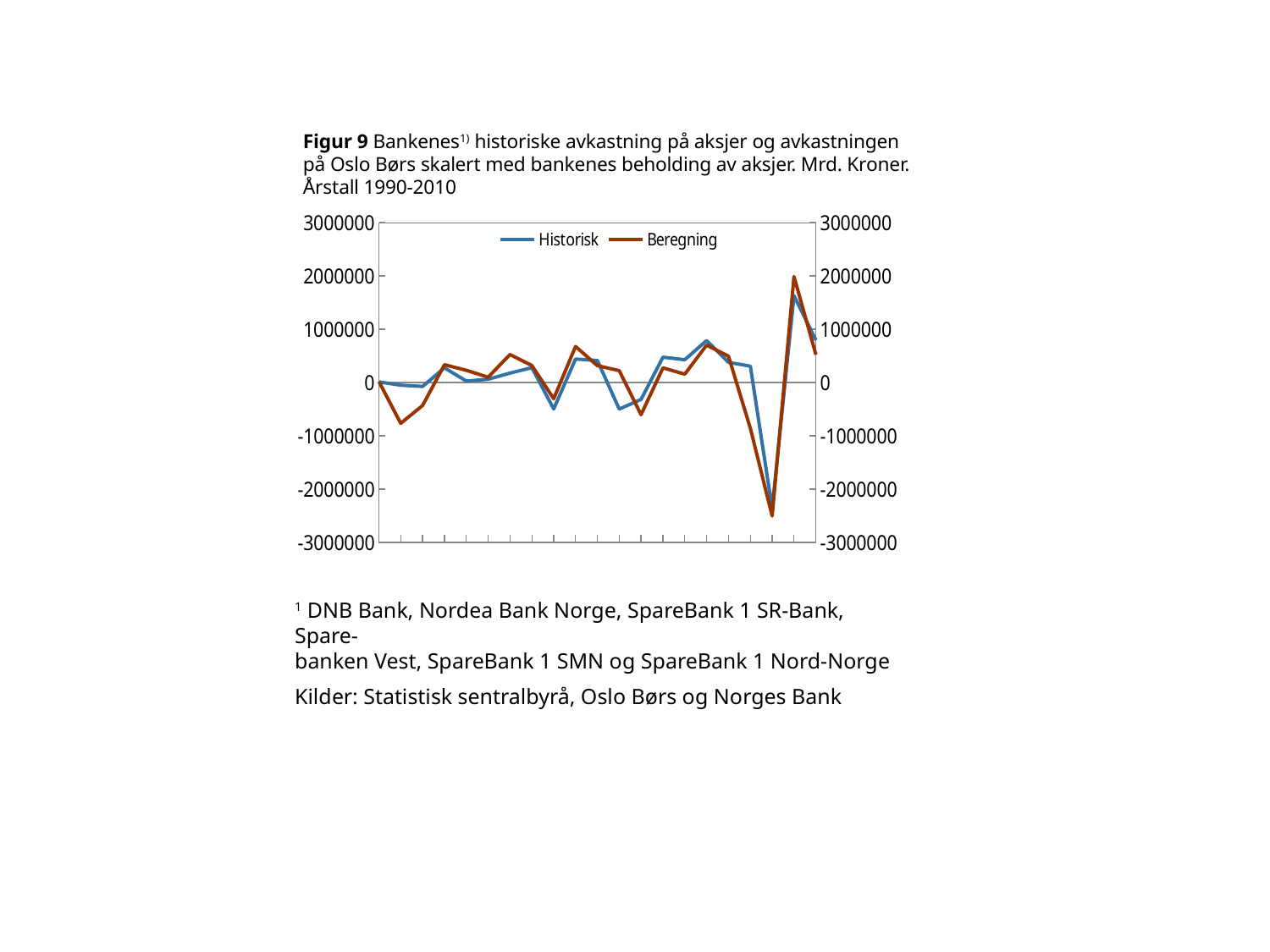
What kind of chart is shown on the slide? line chart Is the highest value of the Historisk series greater or less than 1000000? greater Is the lowest value of the Historisk series greater or less than -1000000? less How many series does the legend list? 2 Is the highest value of the Historisk series greater or less than 2000000? less Which series dips below -500000 near the left side of the chart, Historisk or Beregning? Beregning At the right end of the chart, which series ends at a higher value, Historisk or Beregning? Historisk What figure number is given in the chart title? Figur 9 Which series reaches the highest peak on the chart, Historisk or Beregning? Beregning Which series reaches the lowest point on the chart, Historisk or Beregning? Beregning Which colour is used for the Historisk series? blue